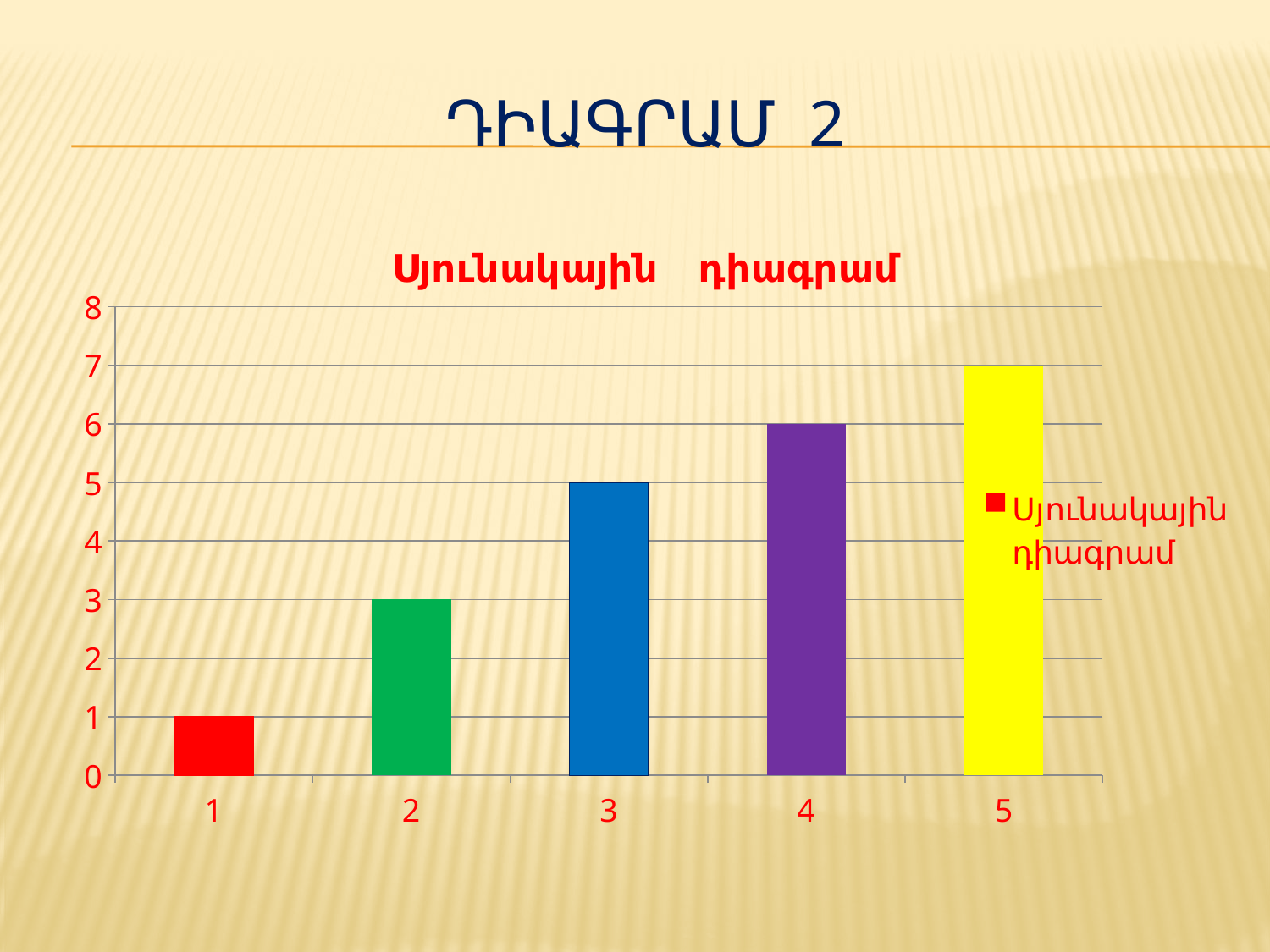
Which category has the lowest value? 1 What is the value for category 2? 3 How many bars are plotted in the chart? 5 Which category has the highest value? 5 What is the difference between the values for category 5 and category 2? 4 What is the value for category 3? 5 Which is larger, the value for category 3 or the value for category 4? category 4 What is the value for category 1? 1 What is the value for category 4? 6 What kind of chart is shown on the slide? bar chart What is the value for category 5? 7 Do the values rise or fall from category 1 to category 5? rise